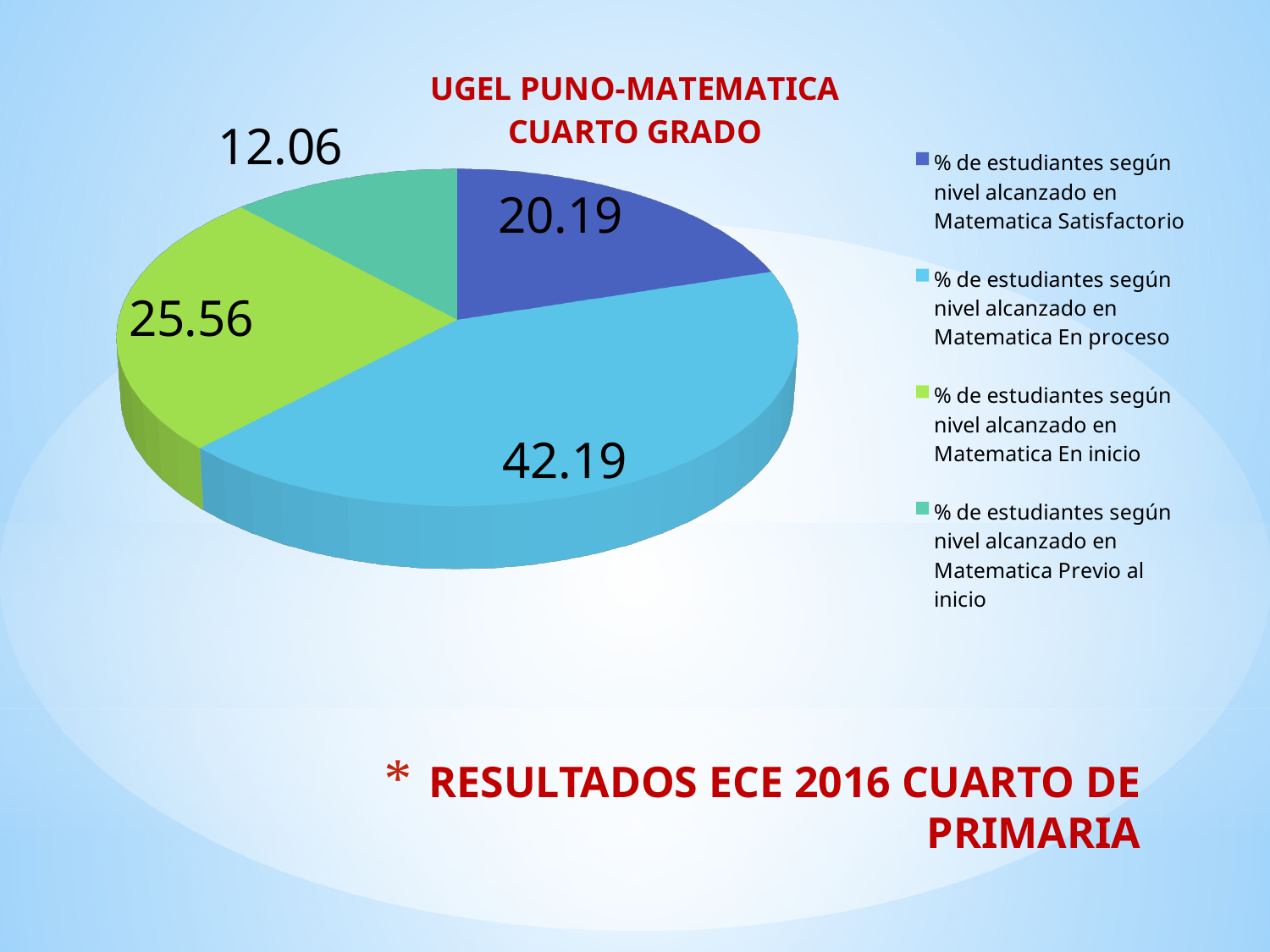
What is the value for the 'Satisfactorio' slice in the pie chart? 20.19 How many slices does the pie chart have? 4 What is the value for the 'En inicio' slice in the pie chart? 25.56 What is the value for the 'En proceso' slice in the pie chart? 42.19 Which level has the smallest slice in the pie chart? Previo al inicio What is the title of the chart? UGEL PUNO-MATEMATICA CUARTO GRADO Which level has the largest slice in the pie chart? En proceso What is the value for the 'Previo al inicio' slice in the pie chart? 12.06 Which is larger, the 'En inicio' slice or the 'Satisfactorio' slice? En inicio What is the difference between the 'En proceso' value and the 'Satisfactorio' value? 22 What kind of chart is shown on the slide? Pie chart What is the difference between the 'En inicio' value and the 'Previo al inicio' value? 13.5